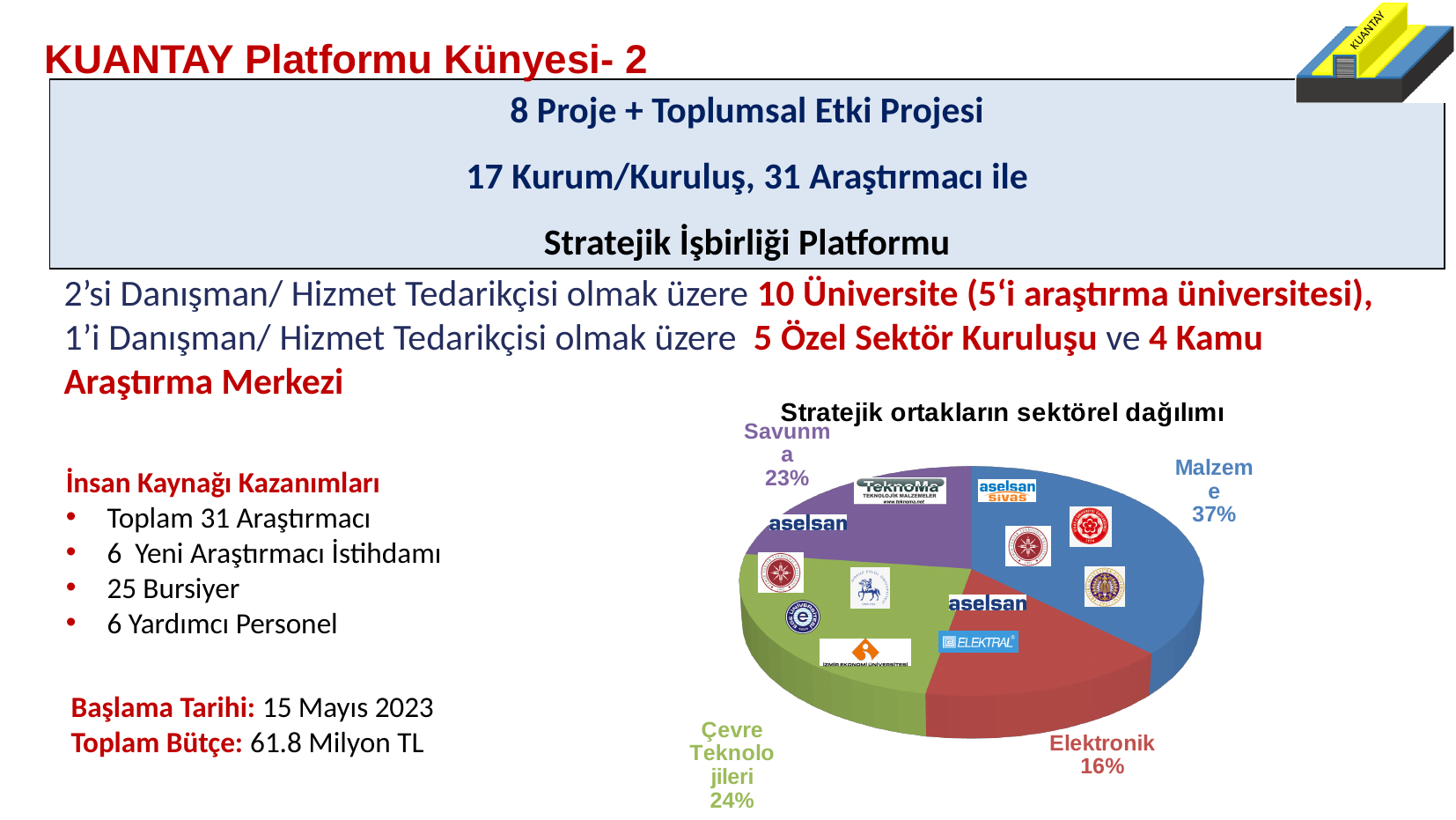
Which is larger, the share for Çevre Teknolojileri or the share for Savunma? Çevre Teknolojileri What share of the pie does Savunma have? 23% How many slices does the pie chart have? 4 What is the title of the chart? Stratejik ortakların sektörel dağılımı Which sector has the largest share of the pie? Malzeme Which sector has the smallest share of the pie? Elektronik What share of the pie does Malzeme have? 37% What type of chart is shown on the slide? pie chart What share of the pie does Çevre Teknolojileri have? 24% What is the difference in percentage points between the Malzeme and Elektronik shares? 21 What colour is the Malzeme slice of the pie? blue